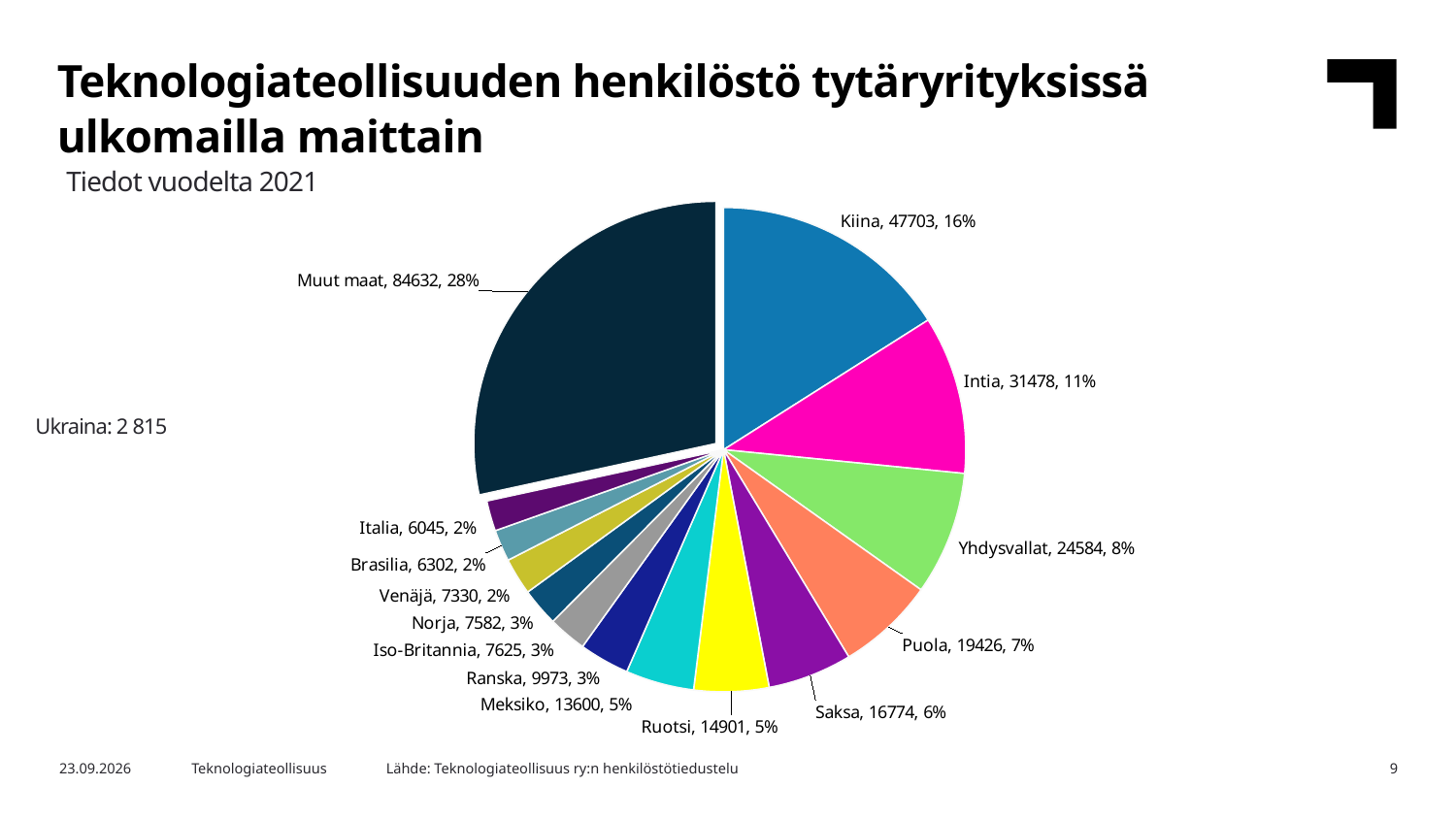
What type of chart is shown on the slide? pie chart What is the value for Ruotsi? 14901 What share of the pie does Intia represent? 11% What is the difference between the values for Kiina and Intia? 16225 Which is larger, the value for Puola or the value for Saksa? Puola How many slices does the pie chart have? 14 What is the value for Kiina? 47703 What year do the data on the slide come from? 2021 What is the value for Yhdysvallat? 24584 Which slice has the smallest value? Italia Which slice has the largest value? Muut maat What share of the pie does Muut maat represent? 28%